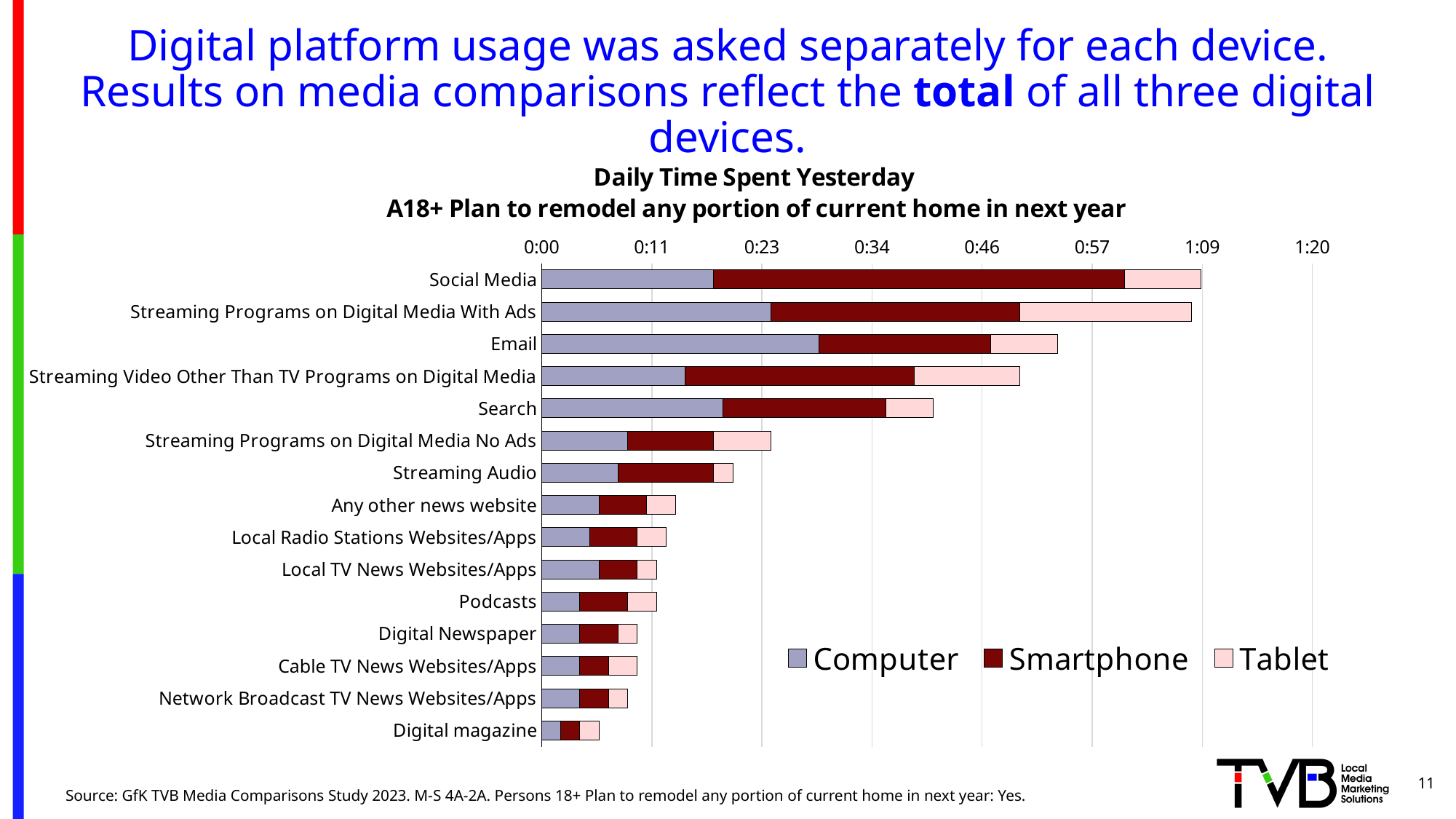
Which has a larger total daily time spent, Email or Search? Email Which has a larger Computer segment, Email or Social Media? Email Is the total daily time spent for Search greater or less than 0:46? less Is the total daily time spent for Streaming Audio greater or less than 0:23? less Do the total bar lengths increase or decrease going from the top category to the bottom category? decrease Which series are listed in the chart legend? Computer, Smartphone, Tablet How many categories (platforms) are plotted on the chart? 15 Is the total daily time spent for Social Media greater or less than 0:57? greater Which platform has the shortest total daily time spent? Digital magazine What is the title of the chart? Daily Time Spent Yesterday A18+ Plan to remodel any portion of current home in next year What kind of chart is shown on the slide? Stacked bar chart How many series does the legend list? 3